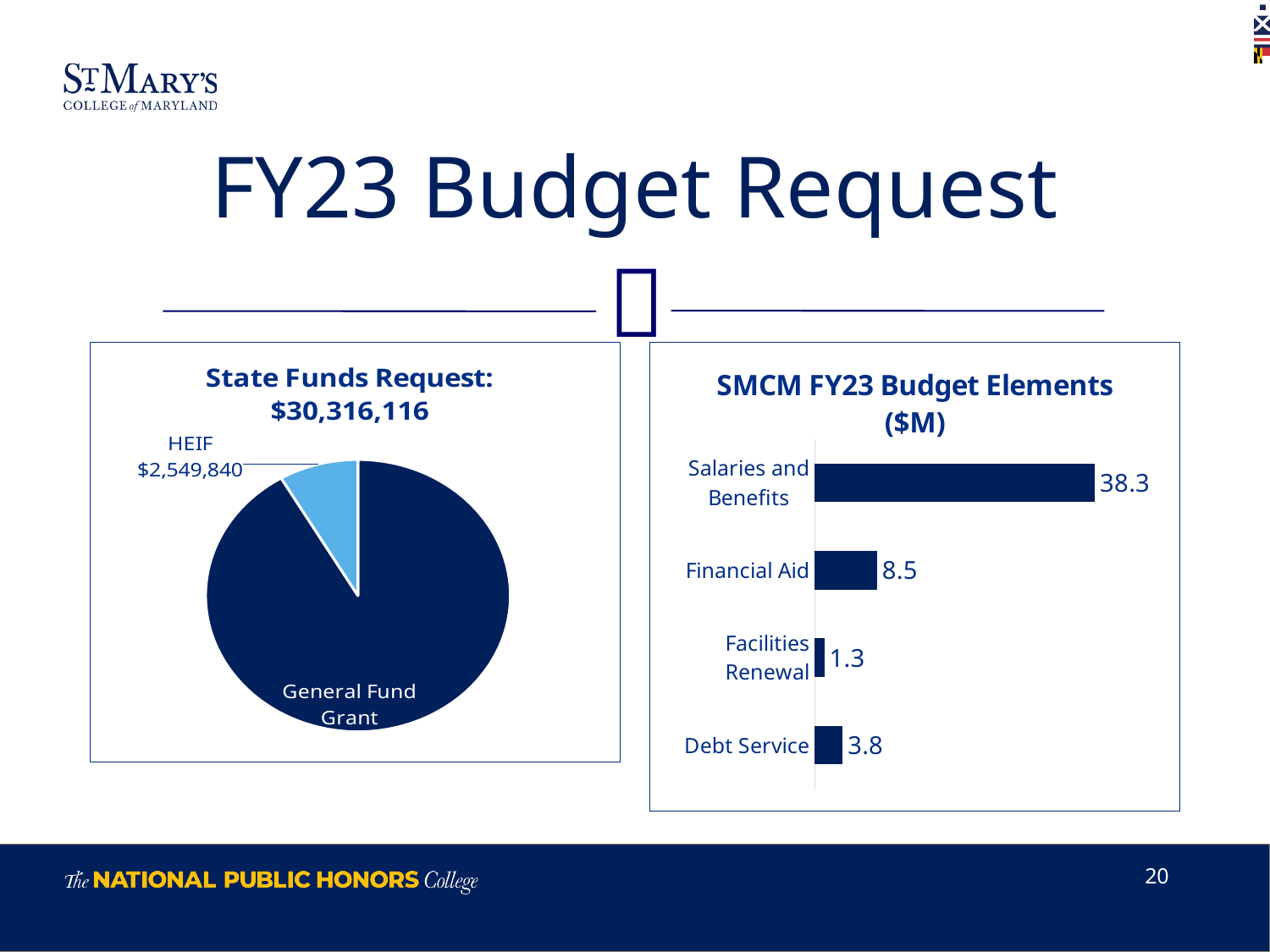
In the SMCM FY23 Budget Elements ($M) chart, what is the value for Financial Aid? 8.5 In the SMCM FY23 Budget Elements ($M) chart, which is larger, Financial Aid or Debt Service? Financial Aid In the SMCM FY23 Budget Elements ($M) chart, what is the value for Salaries and Benefits? 38.3 In the SMCM FY23 Budget Elements ($M) chart, what is the value for Debt Service? 3.8 In the SMCM FY23 Budget Elements ($M) chart, which category has the highest value? Salaries and Benefits In the SMCM FY23 Budget Elements ($M) chart, what is the difference between Salaries and Benefits and Financial Aid? 29.8 In the SMCM FY23 Budget Elements ($M) chart, what is the value for Facilities Renewal? 1.3 How many categories are shown in the SMCM FY23 Budget Elements ($M) chart? 4 In the SMCM FY23 Budget Elements ($M) chart, which category has the lowest value? Facilities Renewal In the State Funds Request pie chart, what is the value shown for HEIF? $2,549,840 What kind of chart is the SMCM FY23 Budget Elements ($M) chart? Bar chart In the SMCM FY23 Budget Elements ($M) chart, what is the difference between Debt Service and Facilities Renewal? 2.5